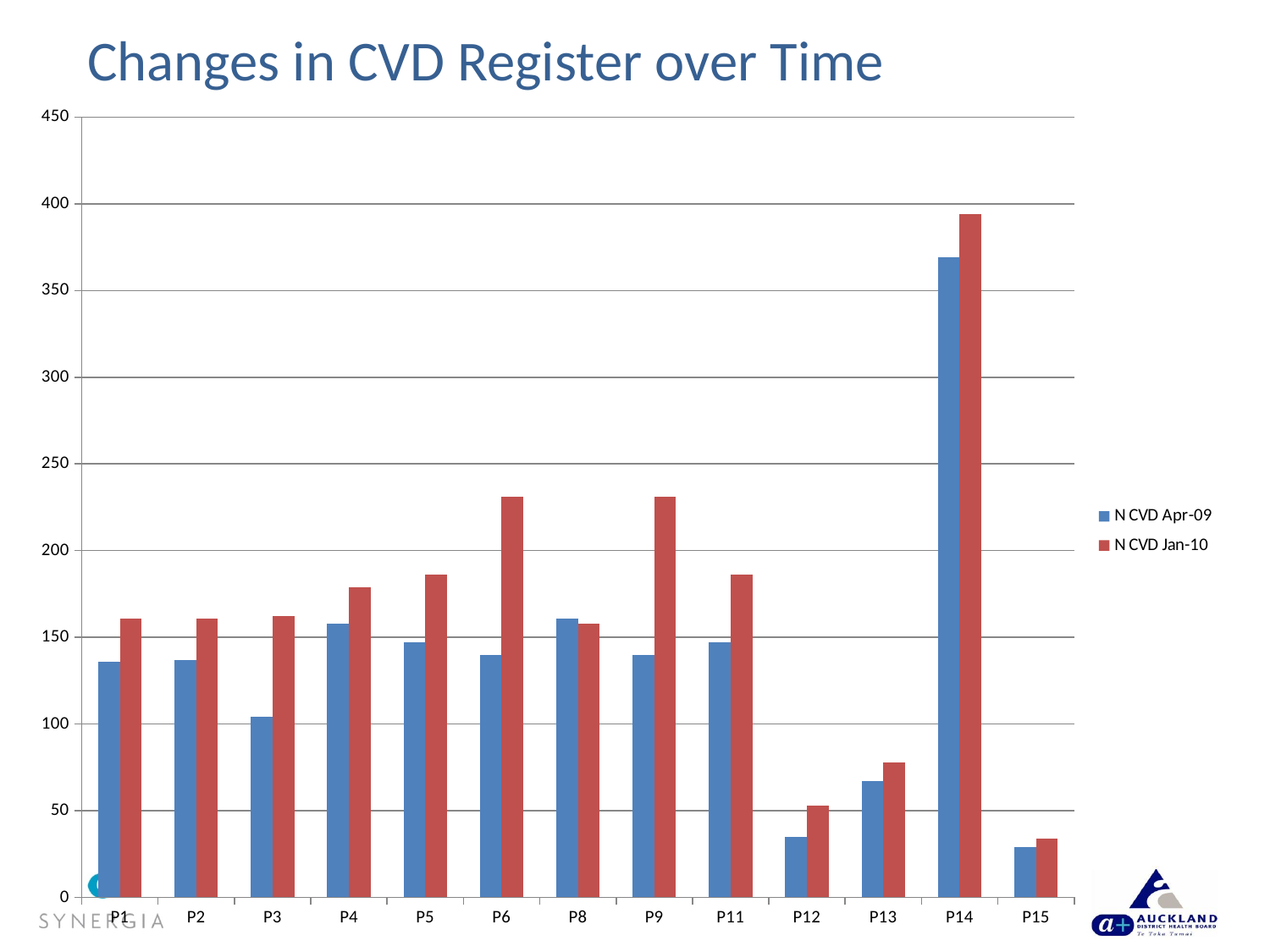
Is the value for N CVD Jan-10 at P6 greater or less than 200? greater Is the value for N CVD Apr-09 at P12 greater or less than 50? less Which category has the highest value for N CVD Jan-10? P14 Which is larger: N CVD Jan-10 at P6 or N CVD Jan-10 at P4? P6 What kind of chart is shown on the slide? bar chart How many series does the legend list? 2 How many categories are shown on the x axis? 13 Is the value for N CVD Jan-10 at P14 greater or less than 350? greater What is the title of the chart? Changes in CVD Register over Time Which is larger: N CVD Apr-09 at P14 or N CVD Apr-09 at P13? P14 Which category has the lowest value for N CVD Jan-10? P15